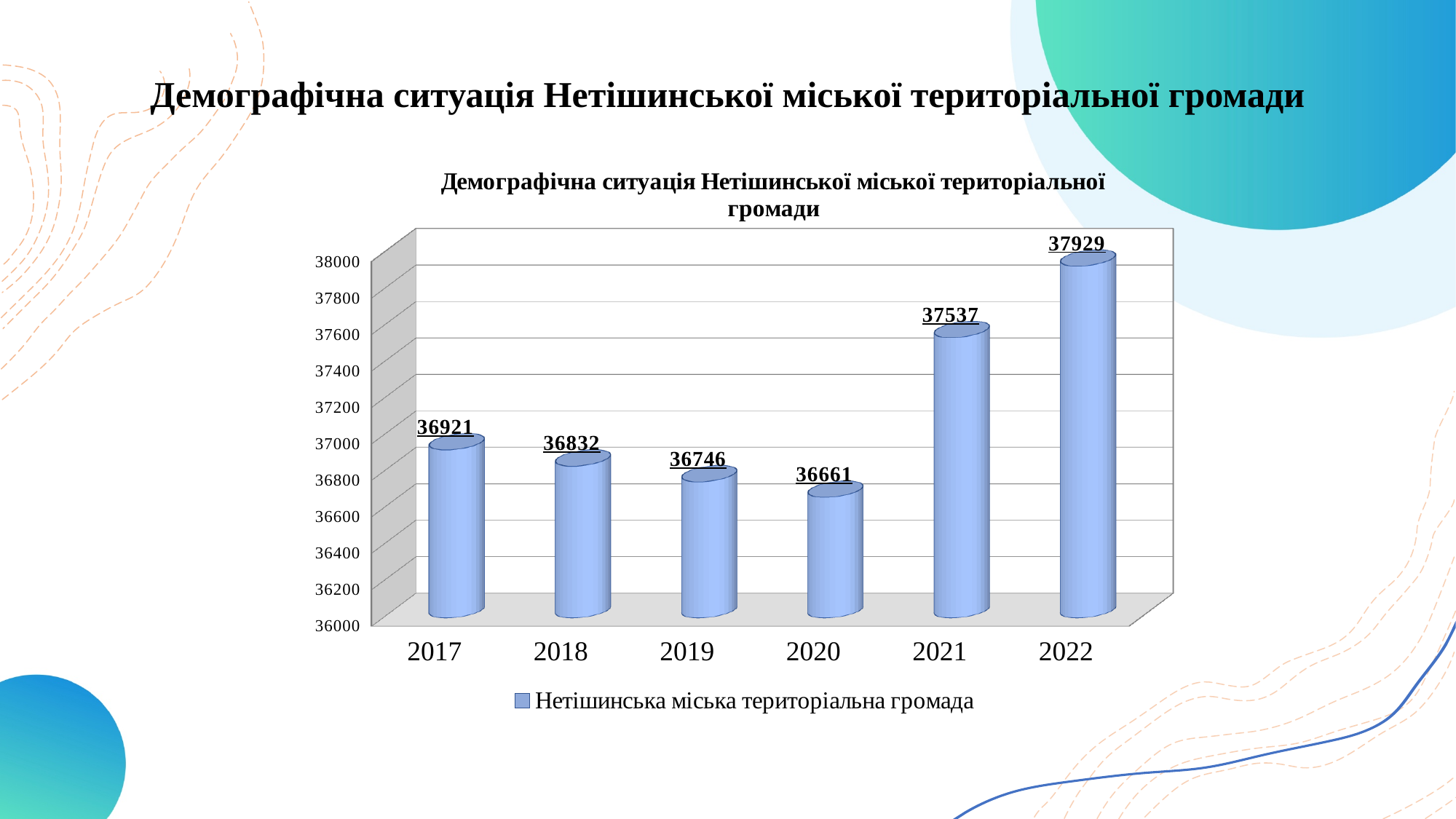
What is the difference between the values for 2022 and 2021? 392 What is the legend entry for the series? Нетішинська міська територіальна громада What is the value for 2022? 37929 What is the difference between the values for 2017 and 2020? 260 What kind of chart is shown on the slide? bar chart Which is larger, the value for 2018 or the value for 2019? 2018 How many years are shown on the x axis? 6 Which year has the highest value? 2022 What is the value for 2017? 36921 Which year has the lowest value? 2020 Is the value for 2021 greater or less than 37400? greater What is the value for 2020? 36661